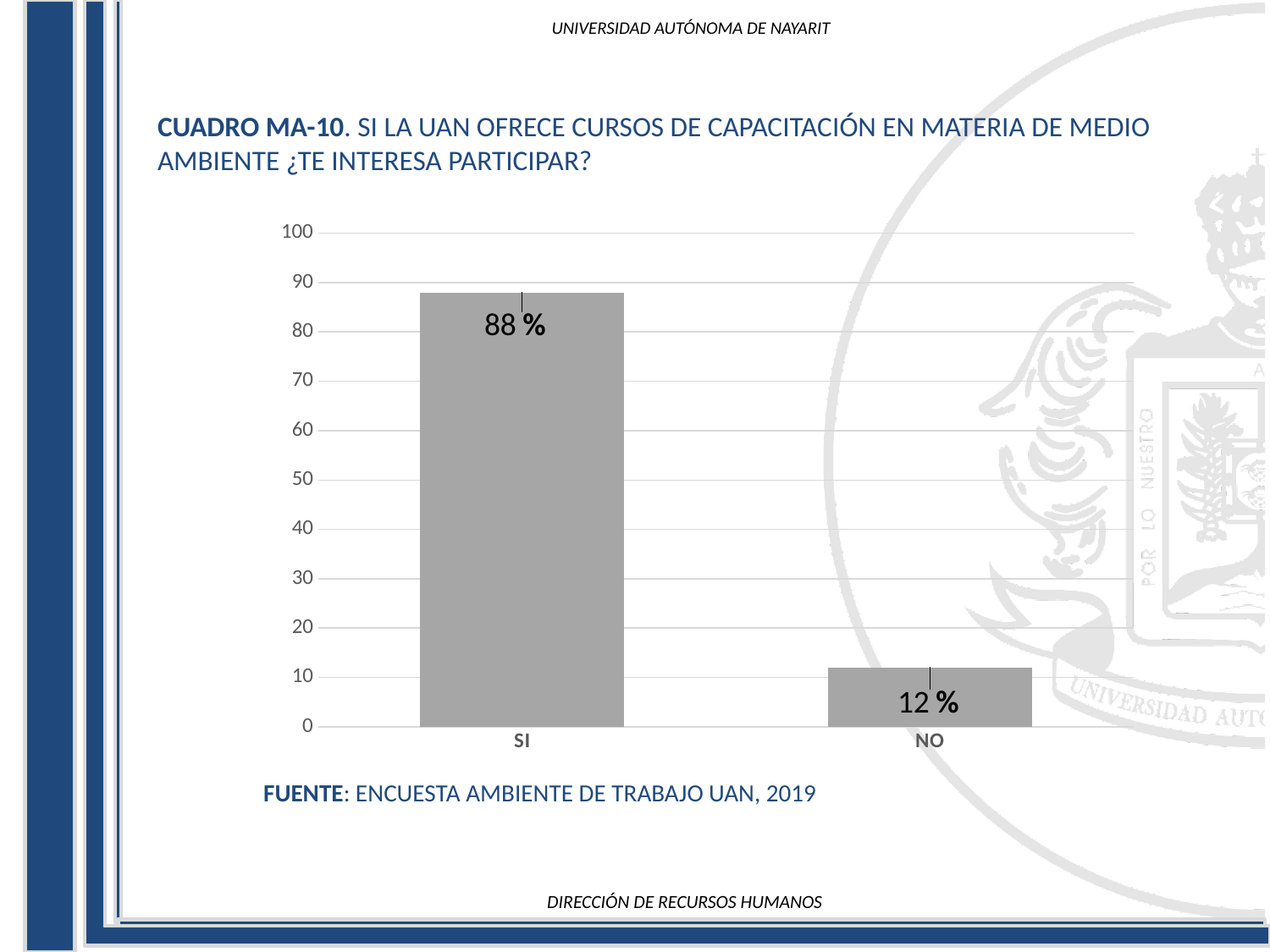
Which category has the highest value? SI What kind of chart is shown on the slide? bar chart Which is larger, the value for SI or the value for NO? SI What is the value for NO? 12 % Is the value for SI greater or less than 80? greater Which category has the lowest value? NO How many categories are shown on the x axis? 2 What is the value for SI? 88 % What source is cited below the chart? ENCUESTA AMBIENTE DE TRABAJO UAN, 2019 What is the difference between the values for SI and NO? 76 % Is the value for NO greater or less than 20? less What is the highest value shown on the y axis? 100